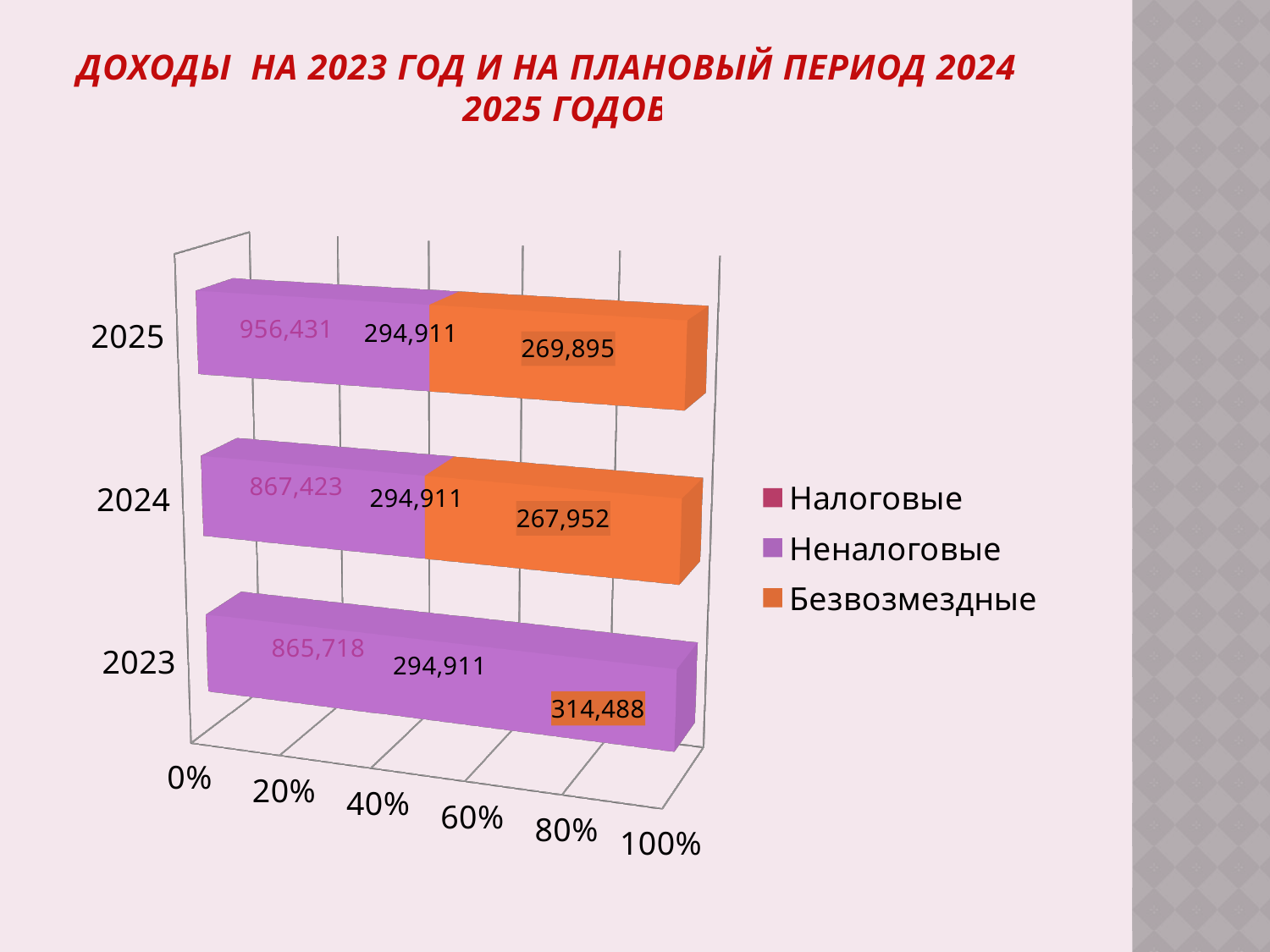
How many series does the legend list? 3 Which year's bar carries the label 956,431? 2025 What value is labelled on the orange (Безвозмездные) segment of the 2025 bar? 269,895 What value is labelled in the orange box on the 2023 bar? 314,488 Which series is shown in purple according to the legend? Неналоговые What kind of chart is shown on the slide? Stacked bar chart What value is labelled on the orange (Безвозмездные) segment of the 2024 bar? 267,952 What is the highest percentage shown on the horizontal axis? 100% Which is larger: the orange-box label for 2023 (314,488) or the Безвозмездные label for 2024 (267,952)? 2023 (314,488) What is the difference between the Безвозмездные labels for 2025 (269,895) and 2024 (267,952)? 1,943 How many years (categories) are shown on the chart? 3 Which series is shown in orange according to the legend? Безвозмездные